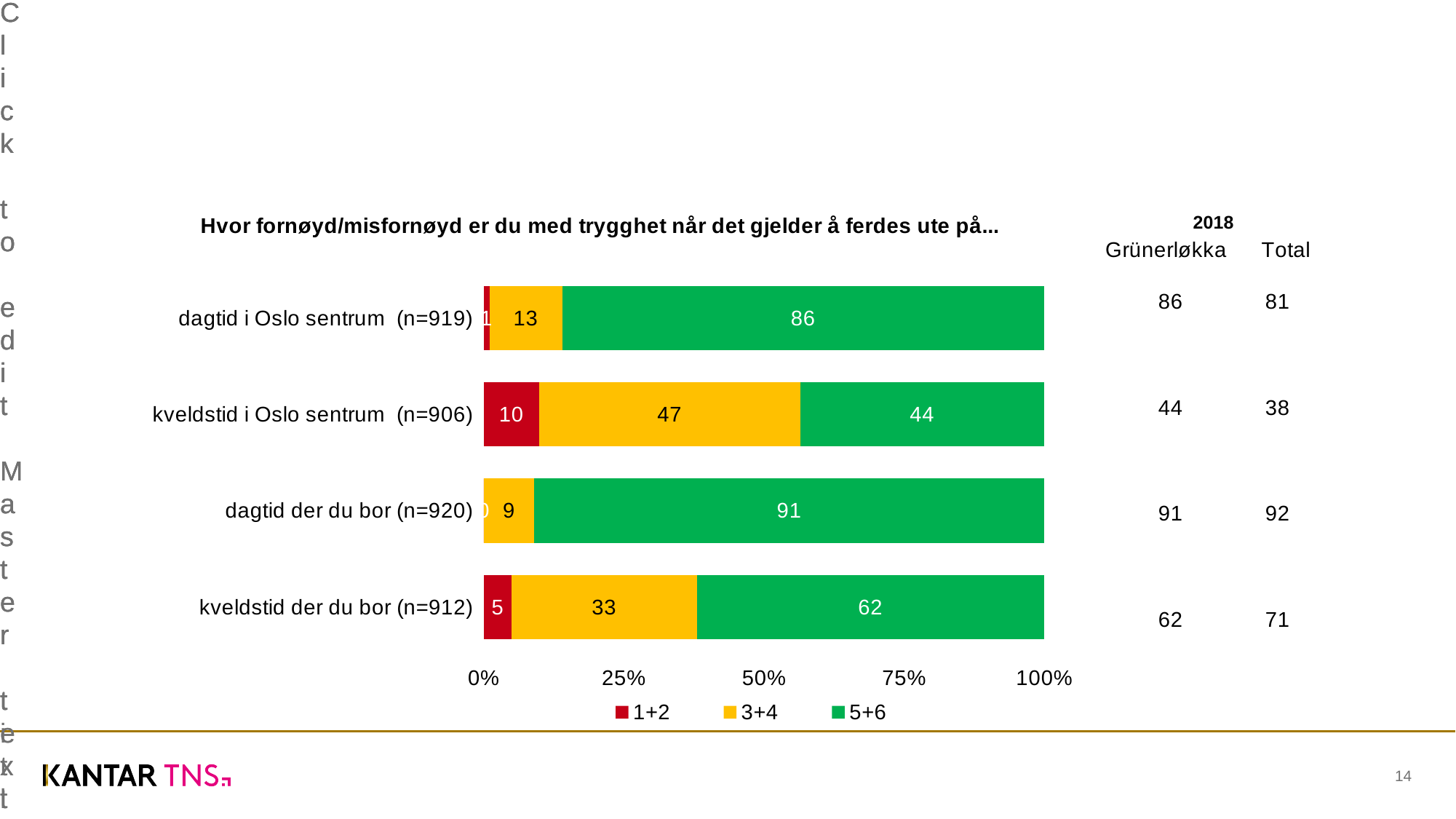
Which category has the lowest value for the 5+6 series? kveldstid i Oslo sentrum (n=906) What is the difference between the 5+6 values for 'dagtid i Oslo sentrum (n=919)' and 'kveldstid der du bor (n=912)'? 24 Which category has the highest value for the 5+6 series? dagtid der du bor (n=920) What is the value of the 1+2 series for 'kveldstid i Oslo sentrum (n=906)'? 10 What is the value of the 3+4 series for 'kveldstid der du bor (n=912)'? 33 How many series does the legend list? 3 What is the value of the 5+6 series for 'kveldstid i Oslo sentrum (n=906)'? 44 Which is larger: the 3+4 value for 'kveldstid i Oslo sentrum (n=906)' or the 3+4 value for 'kveldstid der du bor (n=912)'? kveldstid i Oslo sentrum (n=906) How many categories are plotted in the chart? 4 Which legend entry is shown in green? 5+6 What kind of chart is shown on the slide? stacked bar chart Is the 5+6 value for 'kveldstid der du bor (n=912)' greater or less than 50%? greater